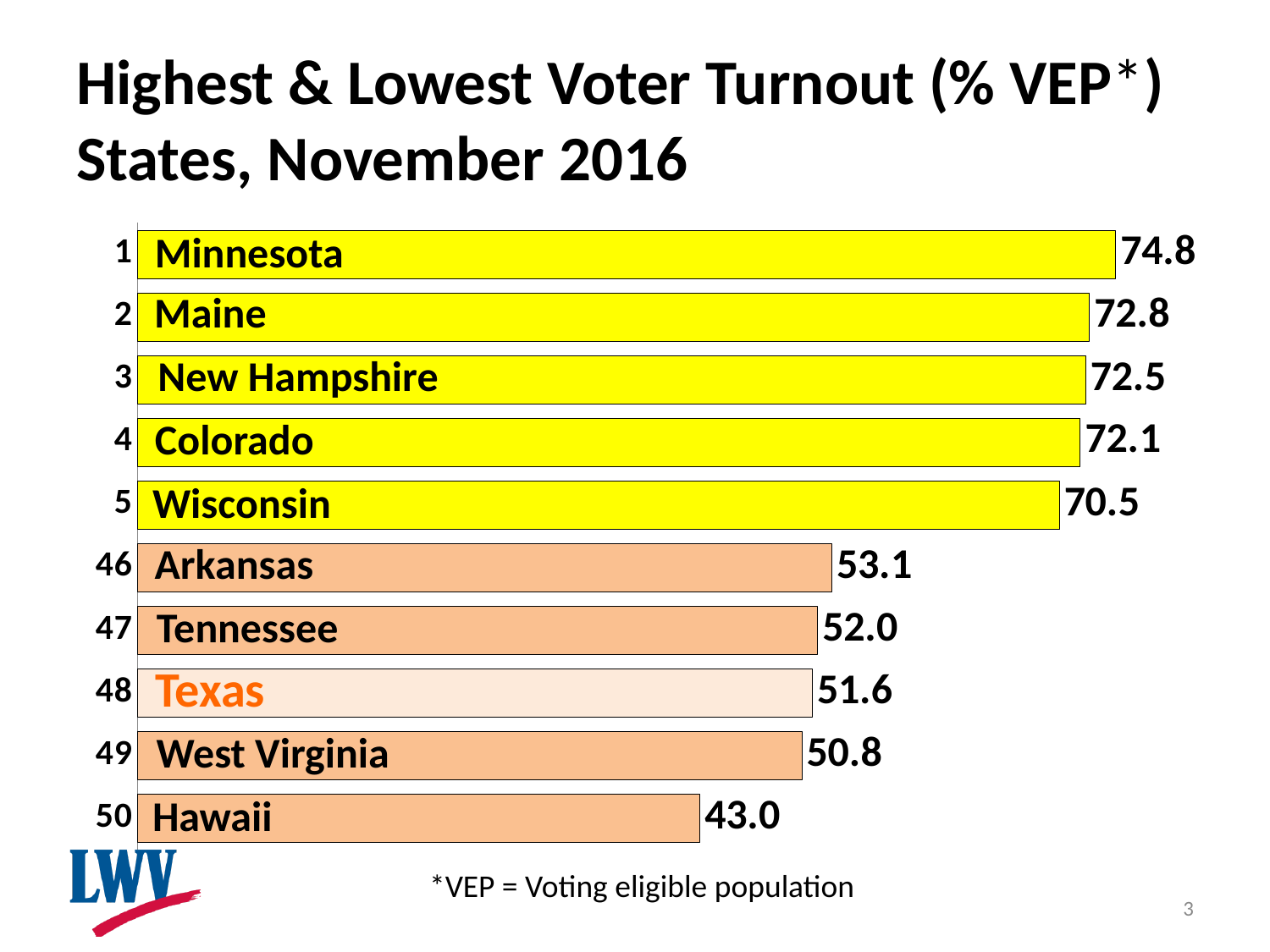
What is the voter turnout value for Texas? 51.6 Which state has the lowest voter turnout on the chart? Hawaii What is the difference between the voter turnout of Arkansas and Tennessee? 1.1 Which state has the highest voter turnout on the chart? Minnesota What kind of chart is shown on the slide? Bar chart Which has a higher voter turnout, Tennessee or West Virginia? Tennessee What is the voter turnout value for Minnesota? 74.8 What is the difference between the voter turnout of Minnesota and Hawaii? 31.8 How many states are shown on the chart? 10 Which has a higher voter turnout, Colorado or Wisconsin? Colorado What is the voter turnout value for West Virginia? 50.8 What rank number is shown next to Texas? 48